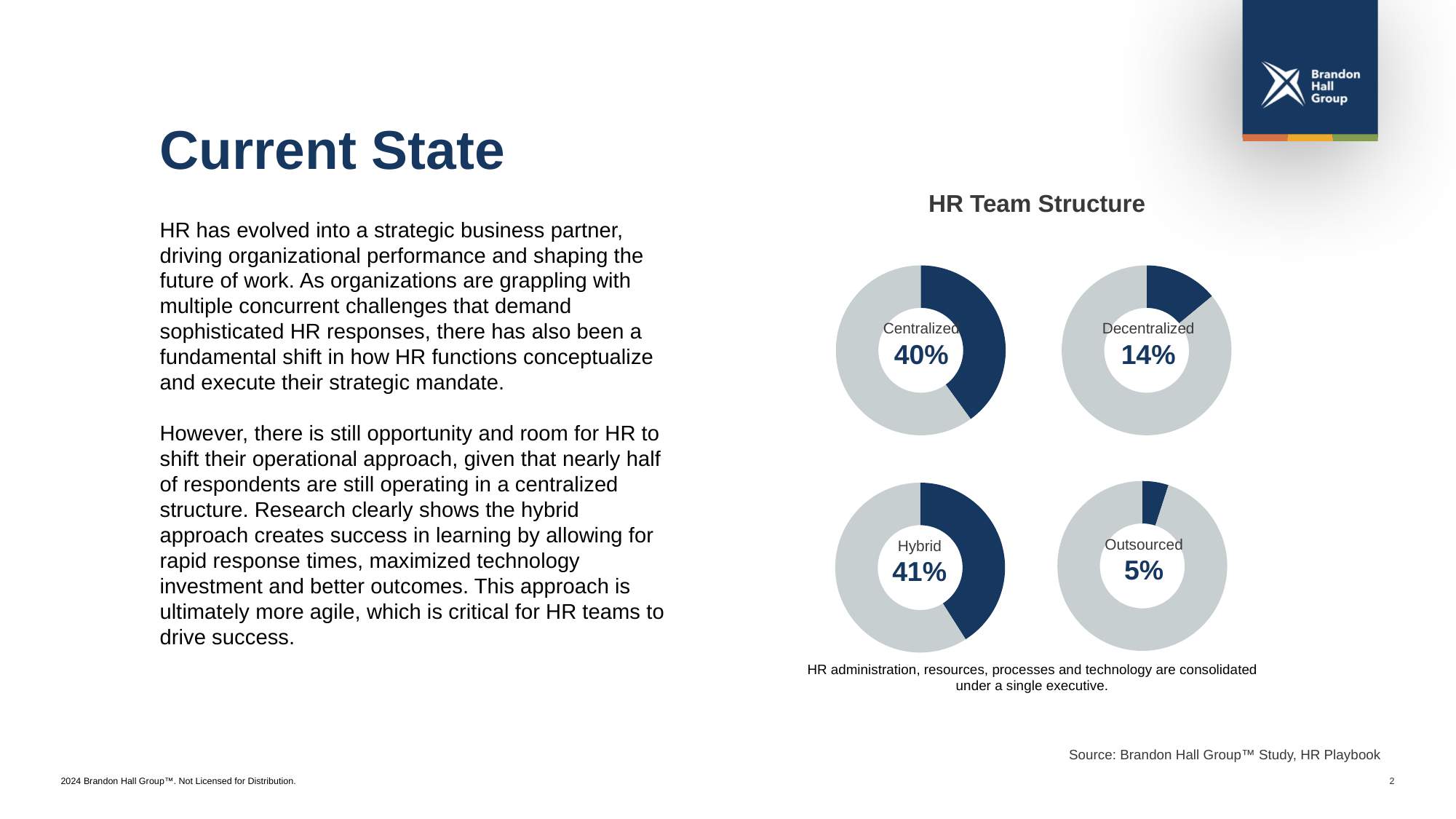
Which HR team structure has the highest percentage? Hybrid What is the difference in percentage points between Centralized and Decentralized? 26 What is the title above the four donut charts? HR Team Structure What is the difference in percentage points between Decentralized and Outsourced? 9 What kind of chart is used to show each HR team structure percentage? Donut (pie) chart Which is larger, the percentage for Centralized or for Decentralized? Centralized In the HR Team Structure charts, what percentage is shown for Hybrid? 41% How many HR team structure categories are shown in the charts? 4 Which HR team structure has the lowest percentage? Outsourced In the HR Team Structure charts, what percentage is shown for Outsourced? 5% In the HR Team Structure charts, what percentage is shown for Centralized? 40% In the HR Team Structure charts, what percentage is shown for Decentralized? 14%